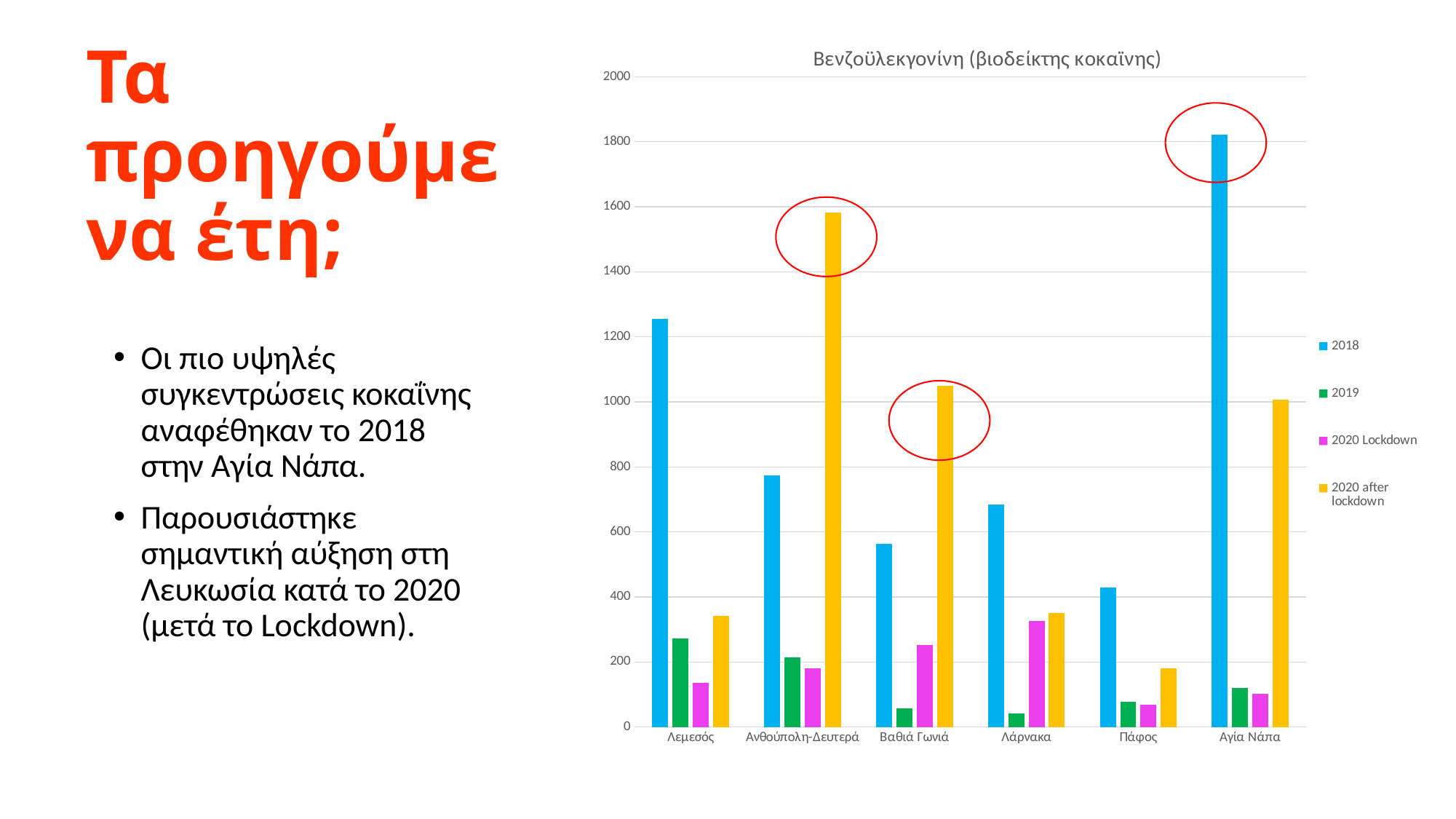
Is the 2020 after lockdown value for Ανθούπολη-Δευτερά greater or less than 1400? greater What kind of chart is shown on the slide? bar chart What is the title of the chart? Βενζοϋλεκγονίνη (βιοδείκτης κοκαϊνης) Which is larger: the 2018 value for Λάρνακα or the 2018 value for Βαθιά Γωνιά? Λάρνακα Is the 2018 value for Λεμεσός greater or less than 1200? greater Which location has the highest value for the 2018 series? Αγία Νάπα Is the 2018 value for Αγία Νάπα greater or less than 1600? greater Which location has the lowest value for the 2018 series? Πάφος How many categories (locations) are shown on the x axis of the chart? 6 Which location has the highest value for the 2020 after lockdown series? Ανθούπολη-Δευτερά How many series does the chart legend list? 4 For Βαθιά Γωνιά, which is larger: the 2018 value or the 2020 after lockdown value? 2020 after lockdown